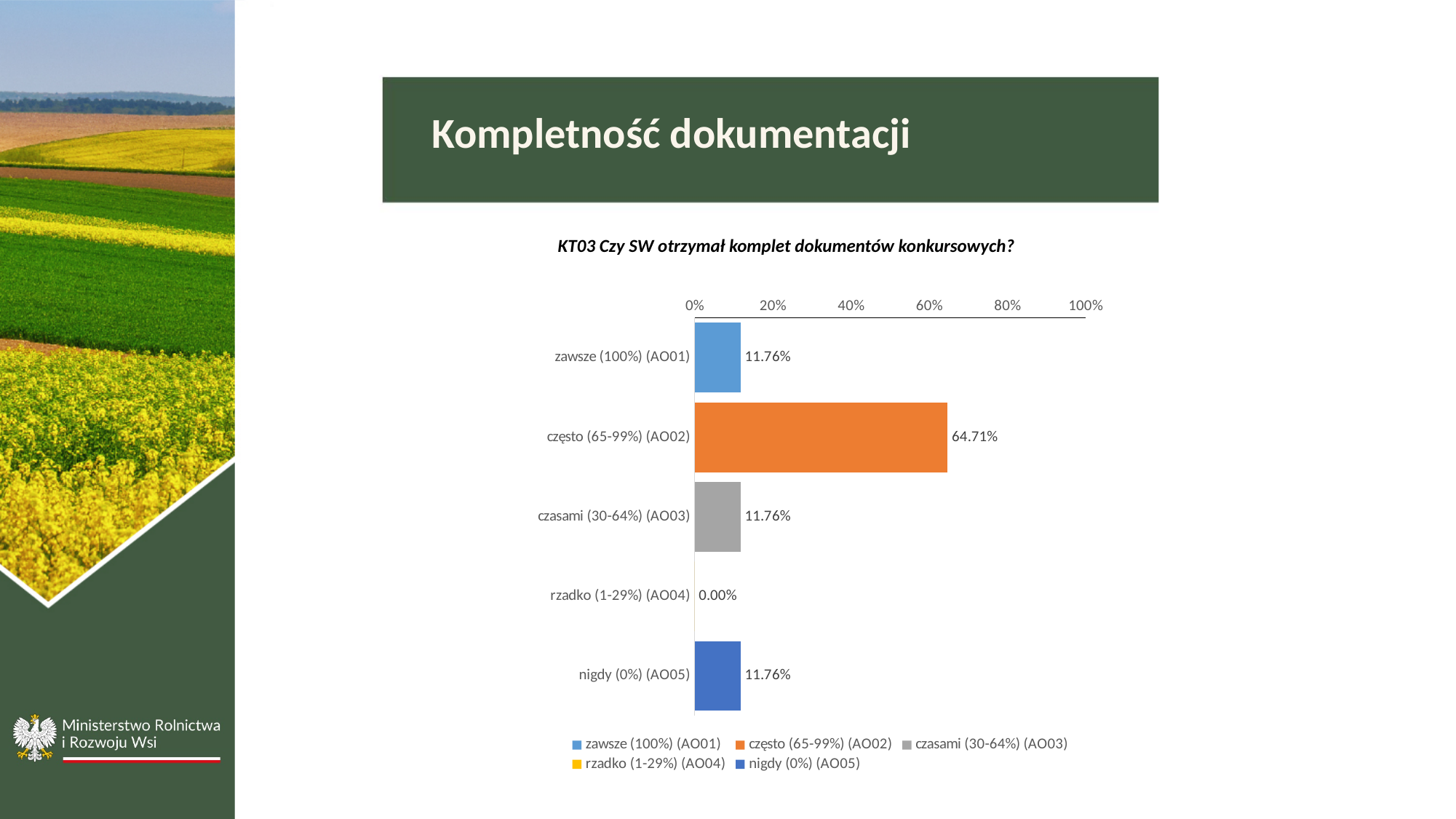
Is the value for często (65-99%) (AO02) greater or less than 60%? greater Which category has the lowest value? rzadko (1-29%) (AO04) What is the value for rzadko (1-29%) (AO04)? 0.00% What is the difference between the values for często (65-99%) (AO02) and czasami (30-64%) (AO03)? 52.95% What is the value for zawsze (100%) (AO01)? 11.76% What is the title of the chart? KT03 Czy SW otrzymał komplet dokumentów konkursowych? Which is larger, the value for często (65-99%) (AO02) or the value for nigdy (0%) (AO05)? często (65-99%) (AO02) How many categories are shown in the chart? 5 What is the value for często (65-99%) (AO02)? 64.71% What is the value for nigdy (0%) (AO05)? 11.76% What kind of chart is shown on the slide? bar chart Which category has the highest value? często (65-99%) (AO02)